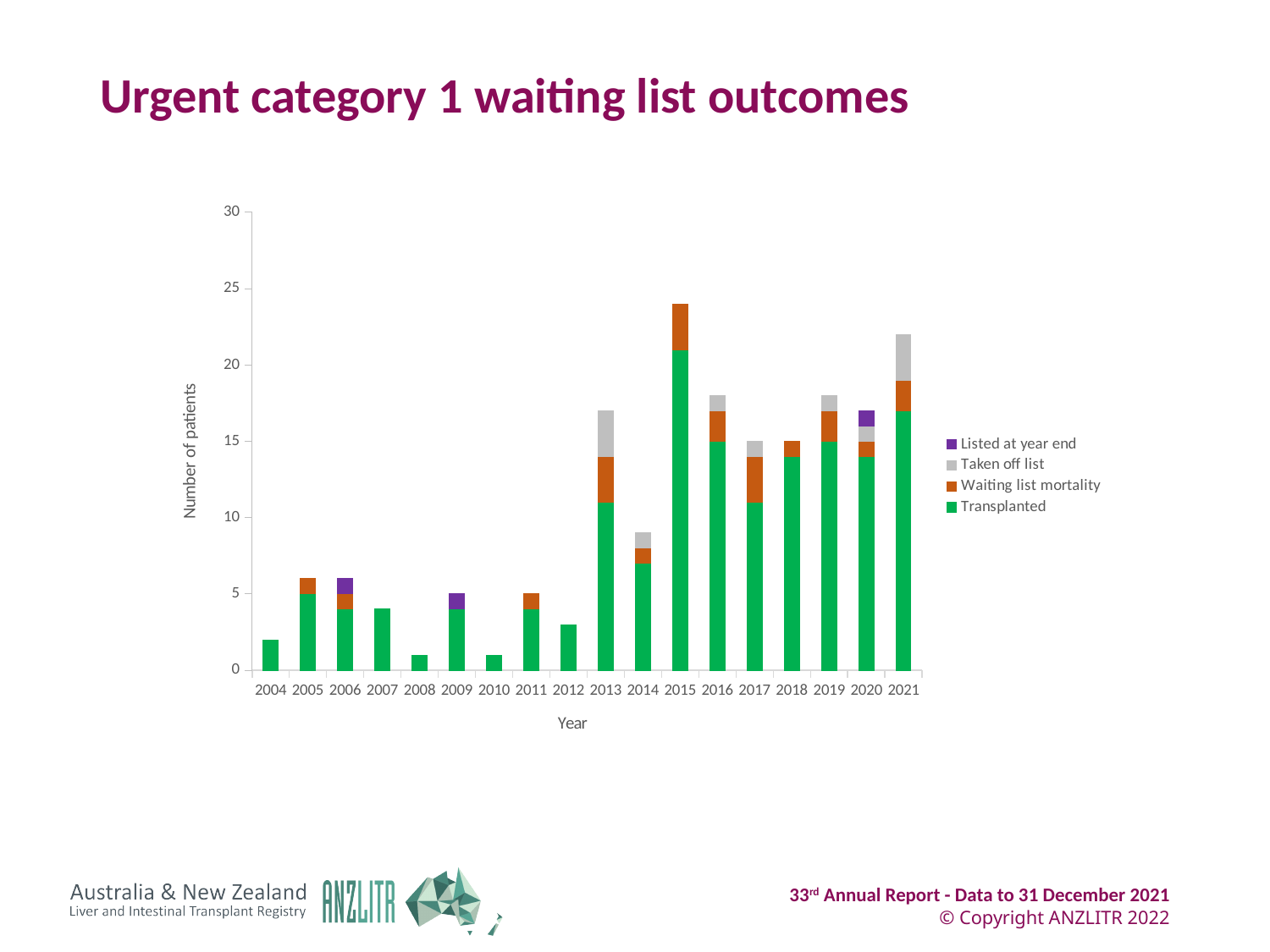
How many years are shown along the x axis? 18 Which year has the larger total number of patients, 2016 or 2017? 2016 Do the total numbers of patients generally rise or fall from 2004 to 2021? rise How many series does the legend list? 4 Which year has the larger total number of patients, 2013 or 2014? 2013 Is the total number of patients for 2004 greater or less than 5? less Is the total number of patients for 2013 greater or less than 15? greater Which year has the highest total number of patients? 2015 Is the total number of patients for 2014 greater or less than 10? less Which colour represents the Transplanted series in the legend? Green What kind of chart is shown on the slide? Stacked bar chart